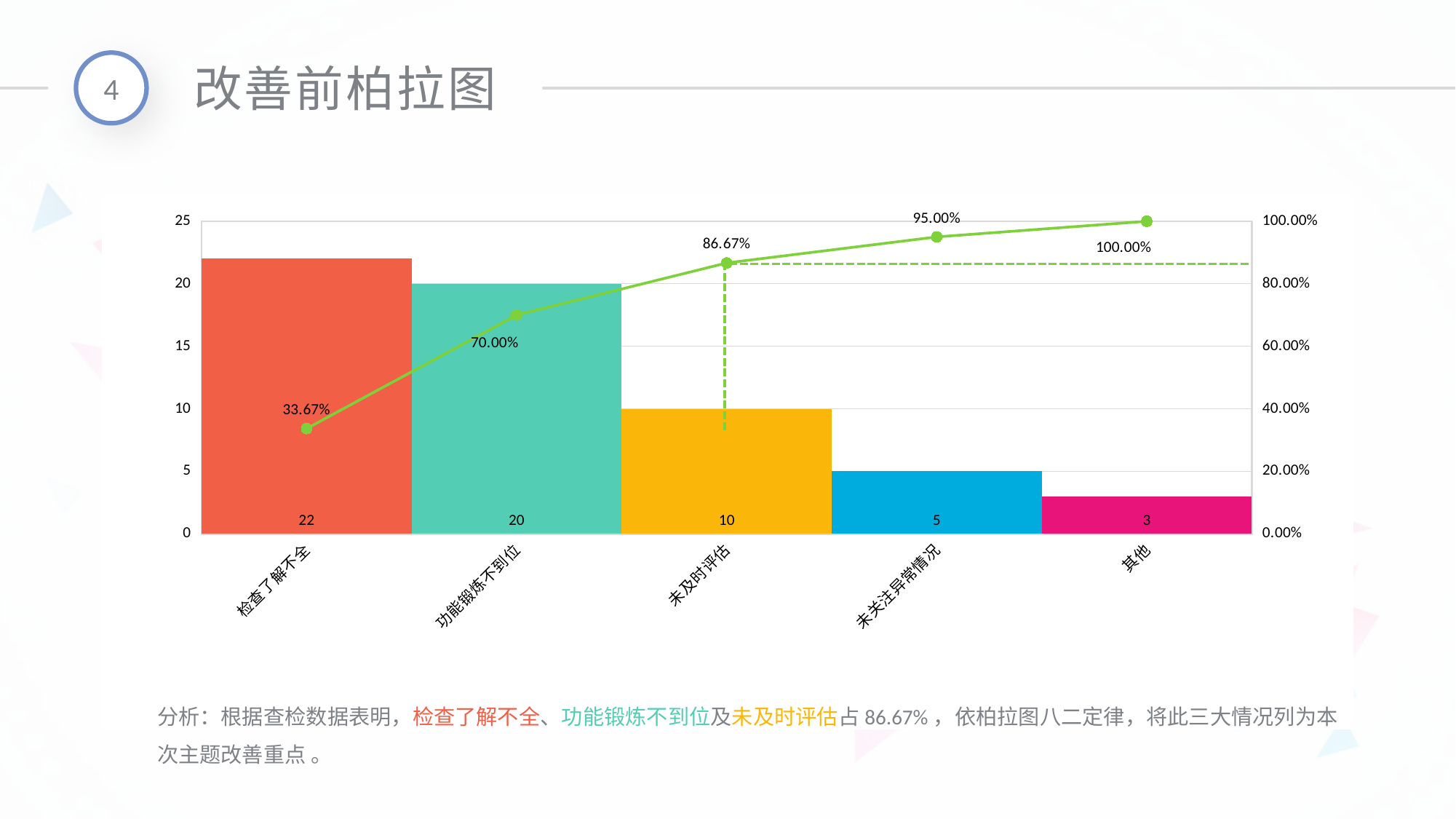
Which is larger, the bar for 未及时评估 or the bar for 其他? 未及时评估 What is the value of the bar for 检查了解不全? 22 Which category has the lowest bar? 其他 What is the value of the bar for 未及时评估? 10 Does the cumulative percentage line rise or fall from left to right? rise What is the title of the slide containing the chart? 改善前柏拉图 How many categories are shown on the x axis? 5 What cumulative percentage is shown at 功能锻炼不到位? 70.00% What is the difference between the bar values for 功能锻炼不到位 and 未关注异常情况? 15 What cumulative percentage is shown at 未关注异常情况? 95.00% Which category has the highest bar? 检查了解不全 What is the total of all five bar values? 60